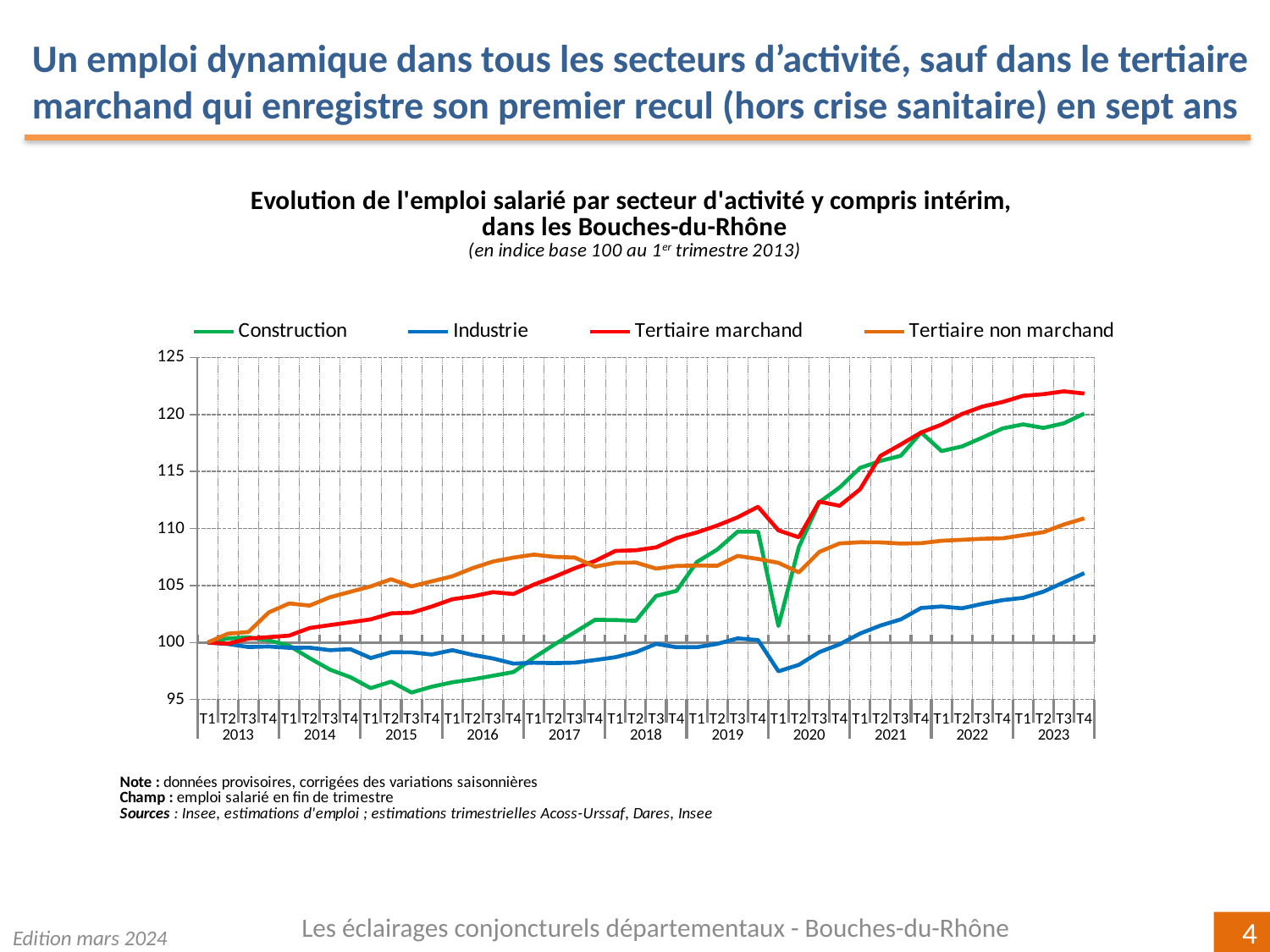
Does the Industrie series rise or fall between T1 2020 and T4 2023? rise What kind of chart is shown on the slide? line chart Which series has the lowest value at T4 2023? Industrie Which series has the highest value at T4 2023? Tertiaire marchand Which series is shown in red in the legend? Tertiaire marchand Is the value for Tertiaire marchand at T4 2023 greater or less than 120? greater How many years are labelled on the x axis? 11 At T4 2023, which is larger: Tertiaire marchand or Industrie? Tertiaire marchand Is the value for Industrie at T1 2020 greater or less than 100? less How many series does the legend list? 4 What is the index value of all series at T1 2013, the base quarter? 100 Is the value for Construction at T3 2015 greater or less than 100? less